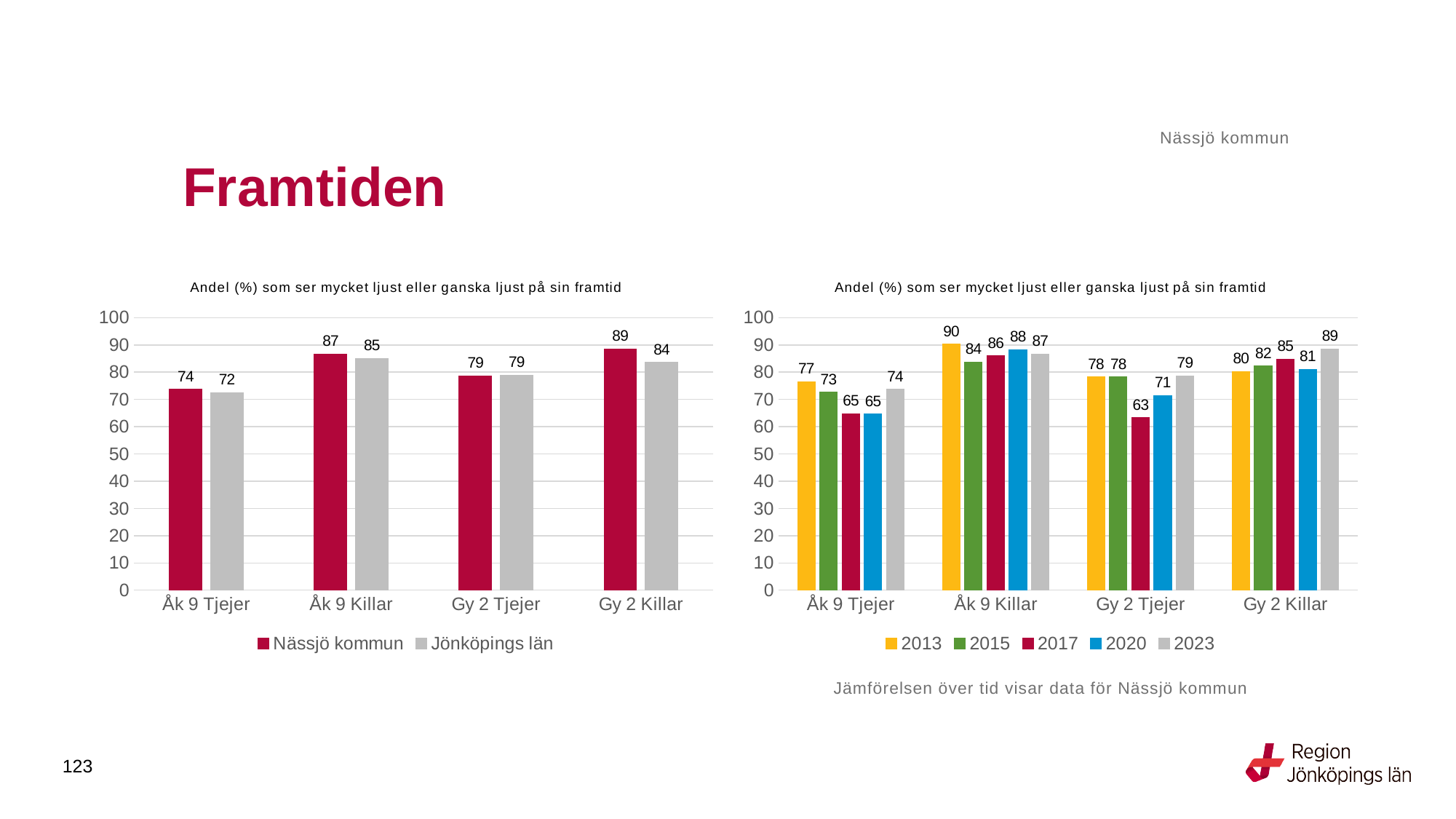
In the right chart, how many series does the legend list? 5 In the right chart, what is the difference between the 2013 and 2017 values for Åk 9 Tjejer? 12 In the left chart, which category has the highest value for Nässjö kommun? Gy 2 Killar In the right chart, which year has the lowest value for Åk 9 Killar? 2015 In the left chart, what is the value for Jönköpings län for Gy 2 Killar? 84 In the right chart, which is larger for Åk 9 Tjejer: the value for 2013 or the value for 2023? 2013 In the left chart, what is the value for Nässjö kommun for Åk 9 Killar? 87 In the right chart, what is the value for 2017 for Gy 2 Tjejer? 63 In the right chart, what is the value for 2023 for Gy 2 Killar? 89 What kind of chart is the right chart? Bar chart In the left chart, how many series does the legend list? 2 In the left chart, what is the difference between Nässjö kommun and Jönköpings län for Åk 9 Tjejer? 2